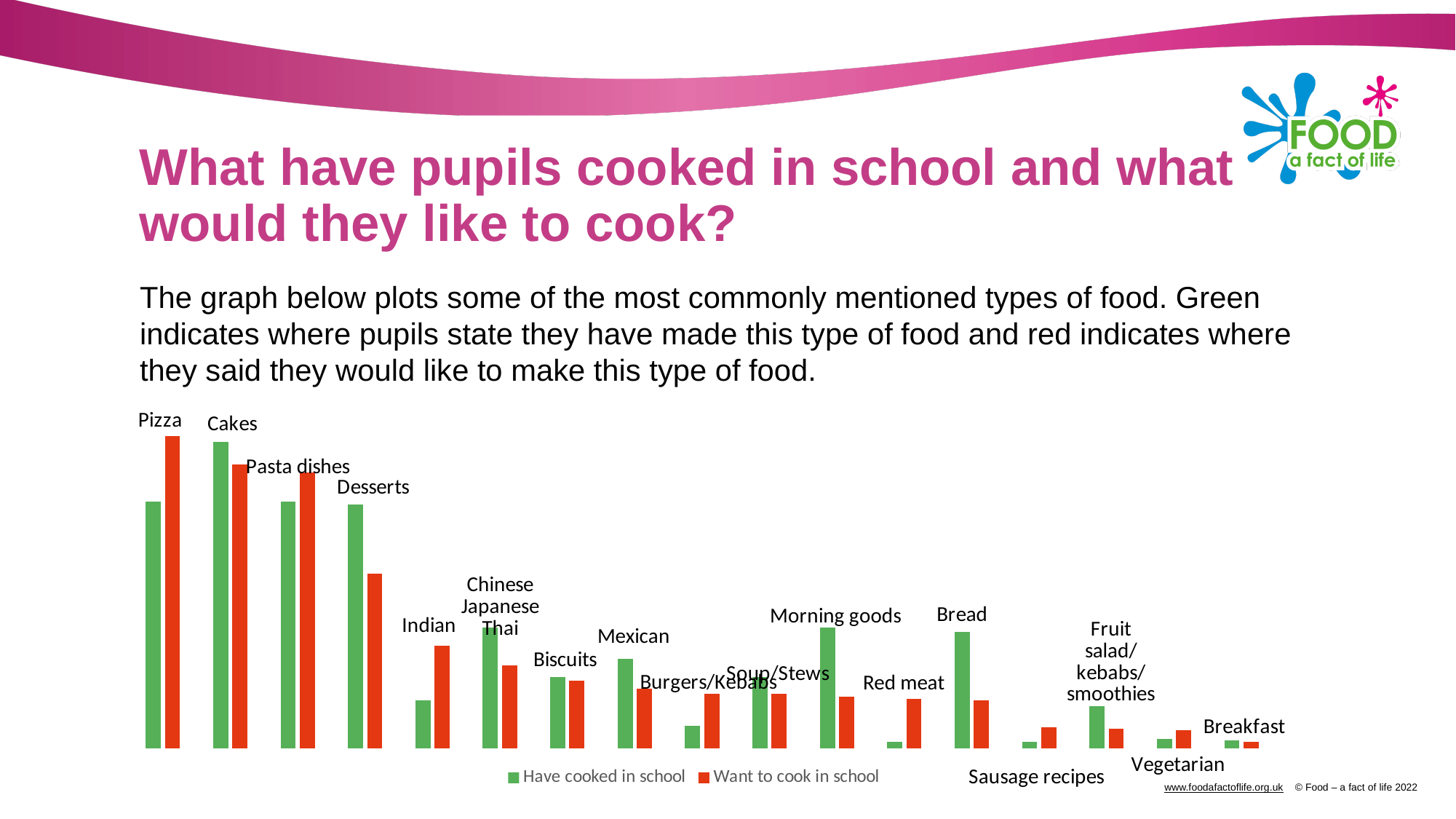
Which colour represents 'Want to cook in school' in the chart? Red For Pizza, which is larger: 'Have cooked in school' or 'Want to cook in school'? Want to cook in school For Morning goods, which is larger: 'Have cooked in school' or 'Want to cook in school'? Have cooked in school Which food category has the highest value for 'Have cooked in school'? Cakes Which food category has the highest value for 'Want to cook in school'? Pizza For Red meat, which is larger: 'Have cooked in school' or 'Want to cook in school'? Want to cook in school How many food categories are plotted in the chart? 17 Which food category has the lowest value for 'Want to cook in school'? Breakfast How many series does the chart legend list? 2 What are the two legend entries of the chart? Have cooked in school; Want to cook in school What kind of chart is shown on the slide? Bar chart